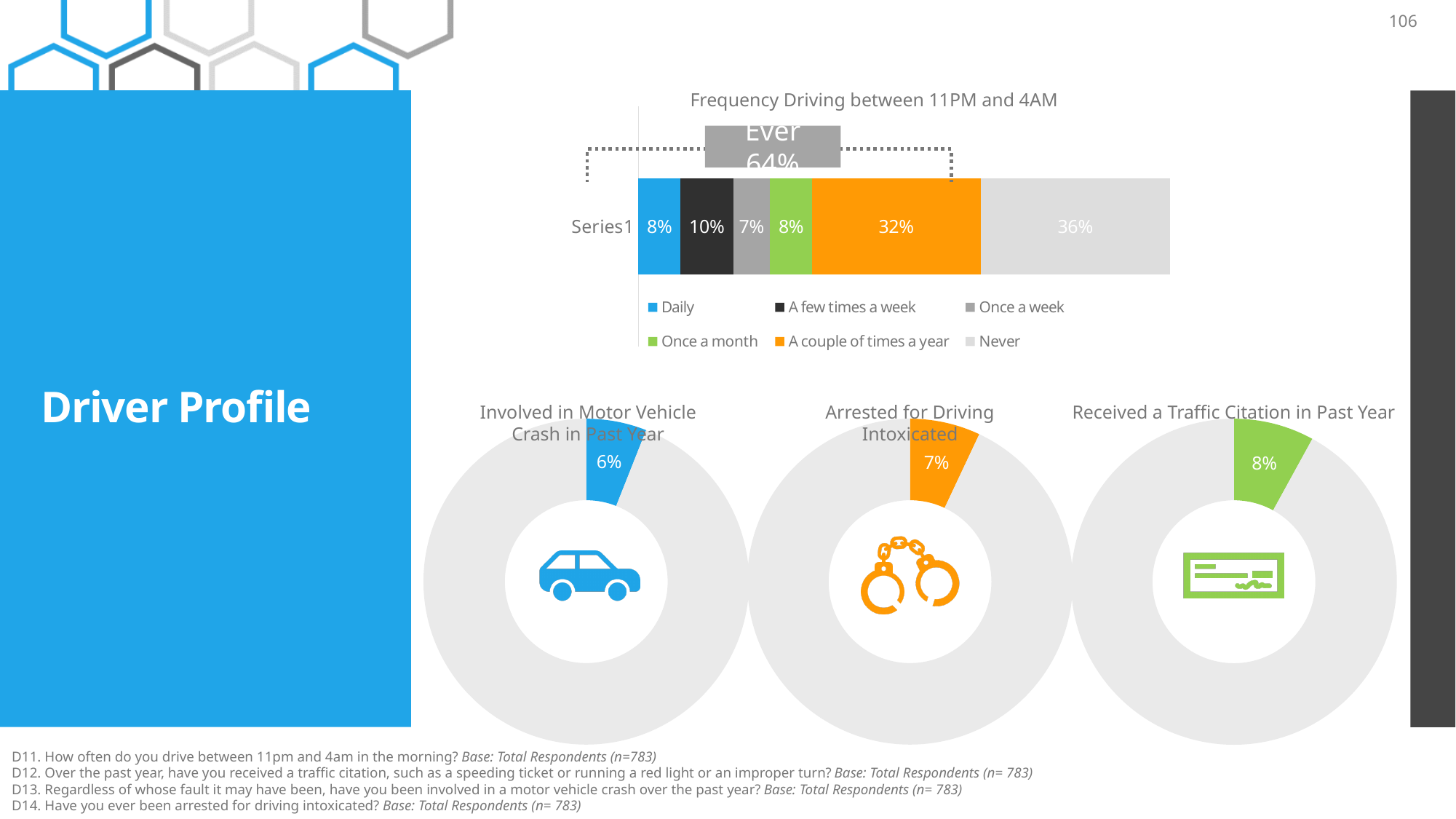
In the 'Frequency Driving between 11PM and 4AM' chart, which category has the smallest share? Once a week In the 'Frequency Driving between 11PM and 4AM' chart, which is larger: 'A few times a week' or 'Once a week'? A few times a week In the 'Frequency Driving between 11PM and 4AM' chart, what percentage of respondents drive daily between 11PM and 4AM? 8% In the 'Frequency Driving between 11PM and 4AM' chart, what is the difference between the 'Never' share and the 'A couple of times a year' share? 4% In the 'Frequency Driving between 11PM and 4AM' chart, which category has the largest share? Never What type of chart is the 'Frequency Driving between 11PM and 4AM' chart? Stacked bar chart How many series does the legend of the 'Frequency Driving between 11PM and 4AM' chart list? 6 In the 'Frequency Driving between 11PM and 4AM' chart, what percentage drive a couple of times a year? 32% In the 'Received a Traffic Citation in Past Year' donut chart, what percentage is shown? 8% In the 'Involved in Motor Vehicle Crash in Past Year' donut chart, what percentage is shown? 6% In the 'Arrested for Driving Intoxicated' donut chart, what percentage is shown? 7% In the 'Frequency Driving between 11PM and 4AM' chart, what percentage of respondents never drive between 11PM and 4AM? 36%